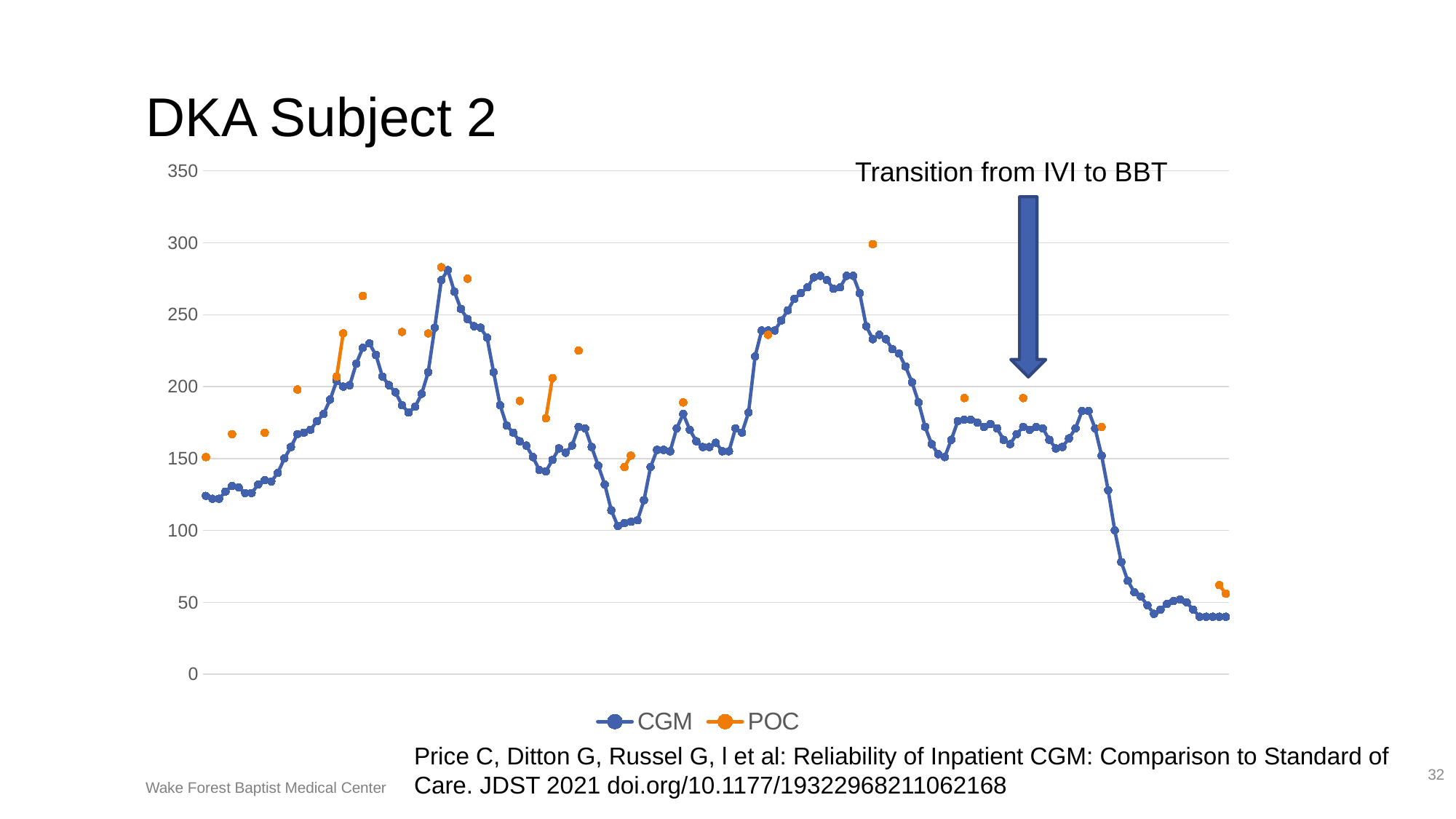
Is the lowest CGM value in the middle section of the chart (around the dip) greater or less than 150? less What kind of chart is shown on the slide? line chart Is the highest POC value on the chart greater or less than 250? greater How many series does the legend list? 2 Comparing the start and the end of the chart, do the CGM values overall rise or fall? fall Are the final CGM values at the right end of the chart greater or less than 50? less What are the two series named in the legend? CGM and POC Which series reaches the single highest value on the chart, CGM or POC? POC What is the title of the slide containing the chart? DKA Subject 2